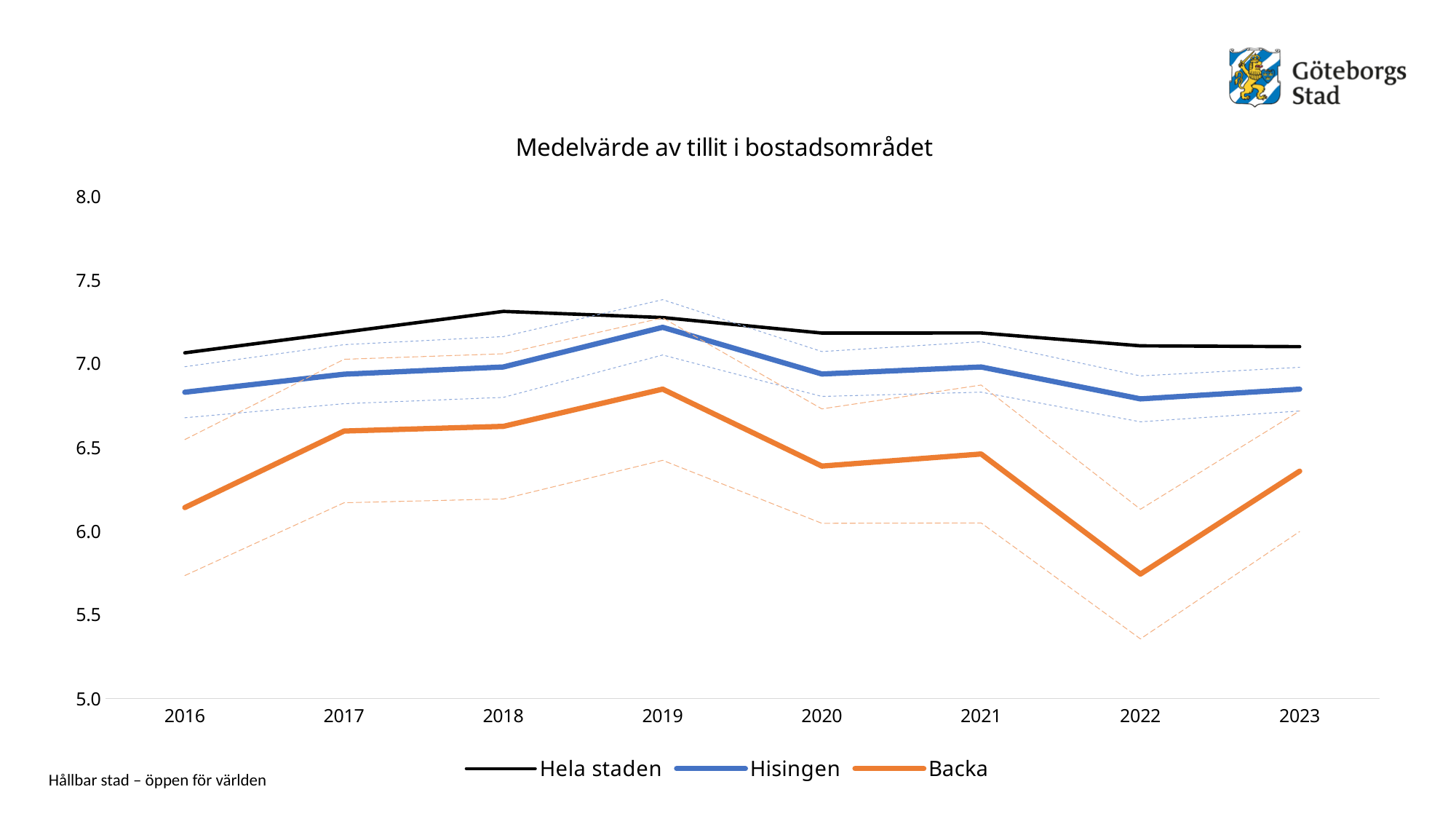
What kind of chart is shown on the slide? line chart Which series is drawn in orange? Backa In which year is the value for Hisingen highest? 2019 How many years are shown on the x axis? 8 How many series does the legend list? 3 Is the value for Backa in 2022 greater or less than 6.0? less In which year is the value for Backa highest? 2019 Does the value for Backa rise or fall from 2021 to 2022? fall In which year is the value for Backa lowest? 2022 Is the value for Hela staden in 2018 greater or less than 7.0? greater What is the title of the chart? Medelvärde av tillit i bostadsområdet Which is larger in 2016, the value for Hela staden or the value for Backa? Hela staden